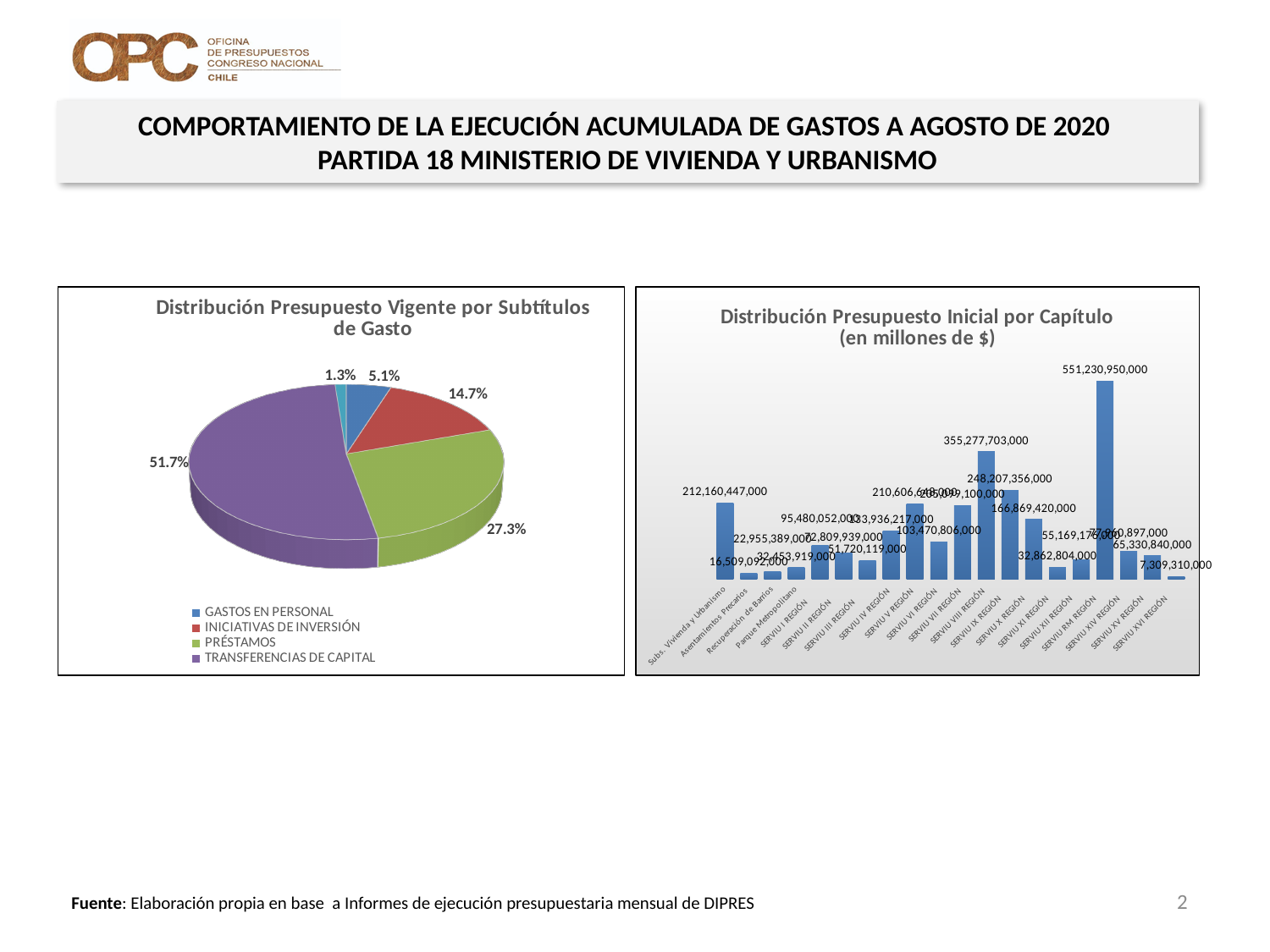
In the pie chart 'Distribución Presupuesto Vigente por Subtítulos de Gasto', which is larger: PRÉSTAMOS or INICIATIVAS DE INVERSIÓN? PRÉSTAMOS In the chart 'Distribución Presupuesto Inicial por Capítulo', what is the value for SERVIU VIII REGIÓN? 355,277,703,000 How many entries does the legend of the pie chart 'Distribución Presupuesto Vigente por Subtítulos de Gasto' list? 4 How many capítulos (bars) are shown in the chart 'Distribución Presupuesto Inicial por Capítulo'? 20 In the pie chart 'Distribución Presupuesto Vigente por Subtítulos de Gasto', what share does TRANSFERENCIAS DE CAPITAL have? 51.7% In the chart 'Distribución Presupuesto Inicial por Capítulo', which is larger: the value for SERVIU IX REGIÓN or the value for SERVIU X REGIÓN? SERVIU IX REGIÓN In the chart 'Distribución Presupuesto Inicial por Capítulo', which capítulo has the highest value? SERVIU RM REGIÓN In the chart 'Distribución Presupuesto Inicial por Capítulo', which capítulo has the lowest value? SERVIU XVI REGIÓN In the chart 'Distribución Presupuesto Inicial por Capítulo', what is the value for SERVIU RM REGIÓN? 551,230,950,000 What kind of chart is 'Distribución Presupuesto Vigente por Subtítulos de Gasto'? Pie chart In the chart 'Distribución Presupuesto Inicial por Capítulo', what is the value for Asentamientos Precarios? 16,509,092,000 In the chart 'Distribución Presupuesto Inicial por Capítulo', what is the difference between the values for SERVIU RM REGIÓN and SERVIU VIII REGIÓN? 195,953,247,000